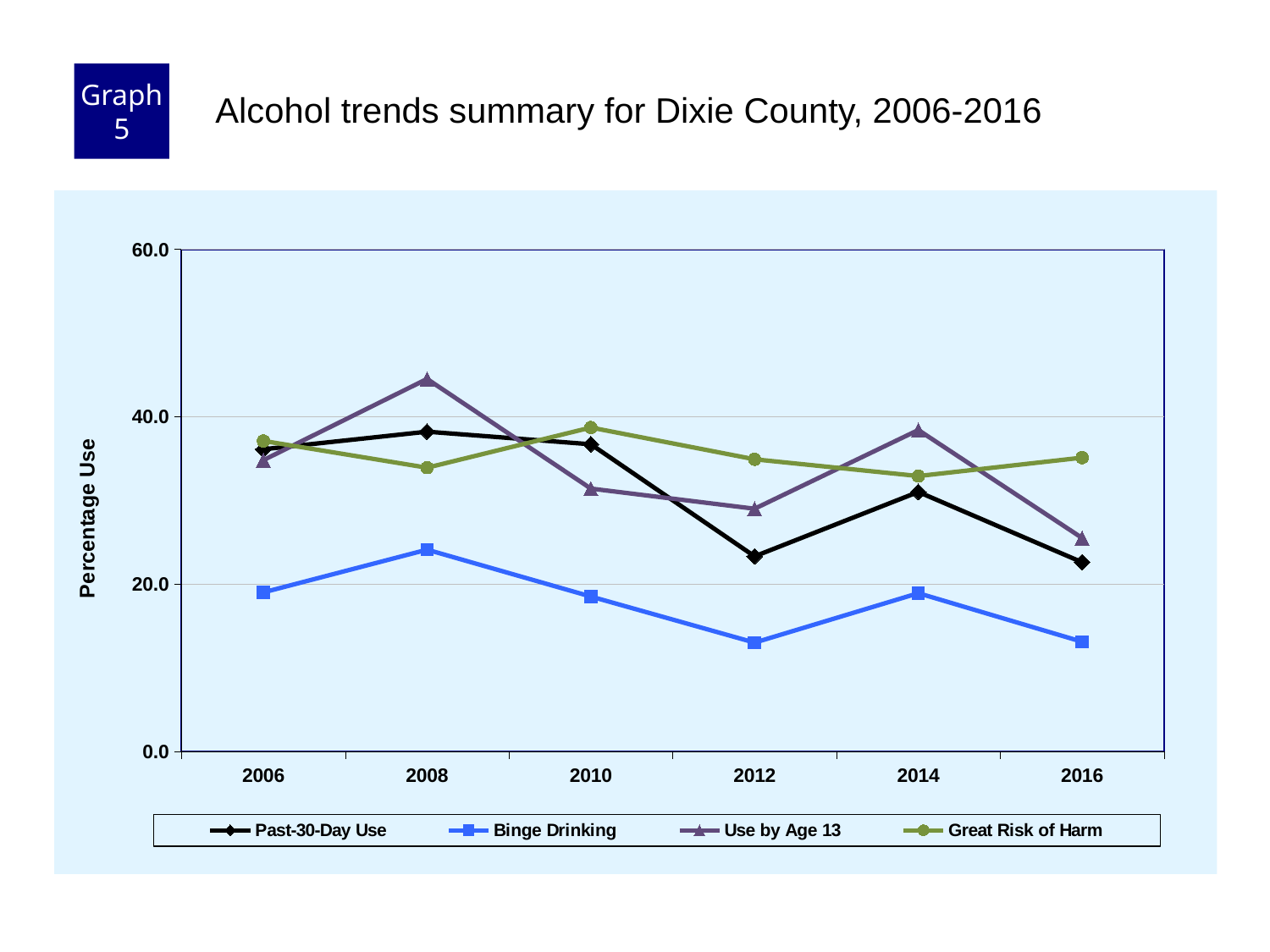
In 2012, which is larger: Past-30-Day Use or Great Risk of Harm? Great Risk of Harm Is the value for Binge Drinking in 2012 greater or less than 20.0? less In which year is Binge Drinking at its highest? 2008 Is the value for Use by Age 13 in 2008 greater or less than 40.0? greater In which year is Use by Age 13 at its highest? 2008 What is the label on the y axis? Percentage Use How many series does the legend list? 4 Is the value for Past-30-Day Use in 2012 greater or less than 20.0? greater Which series has the highest value in 2014? Use by Age 13 How many years are plotted along the x axis? 6 Does Binge Drinking rise or fall from 2008 to 2012? Fall What type of chart is shown on the slide? Line chart